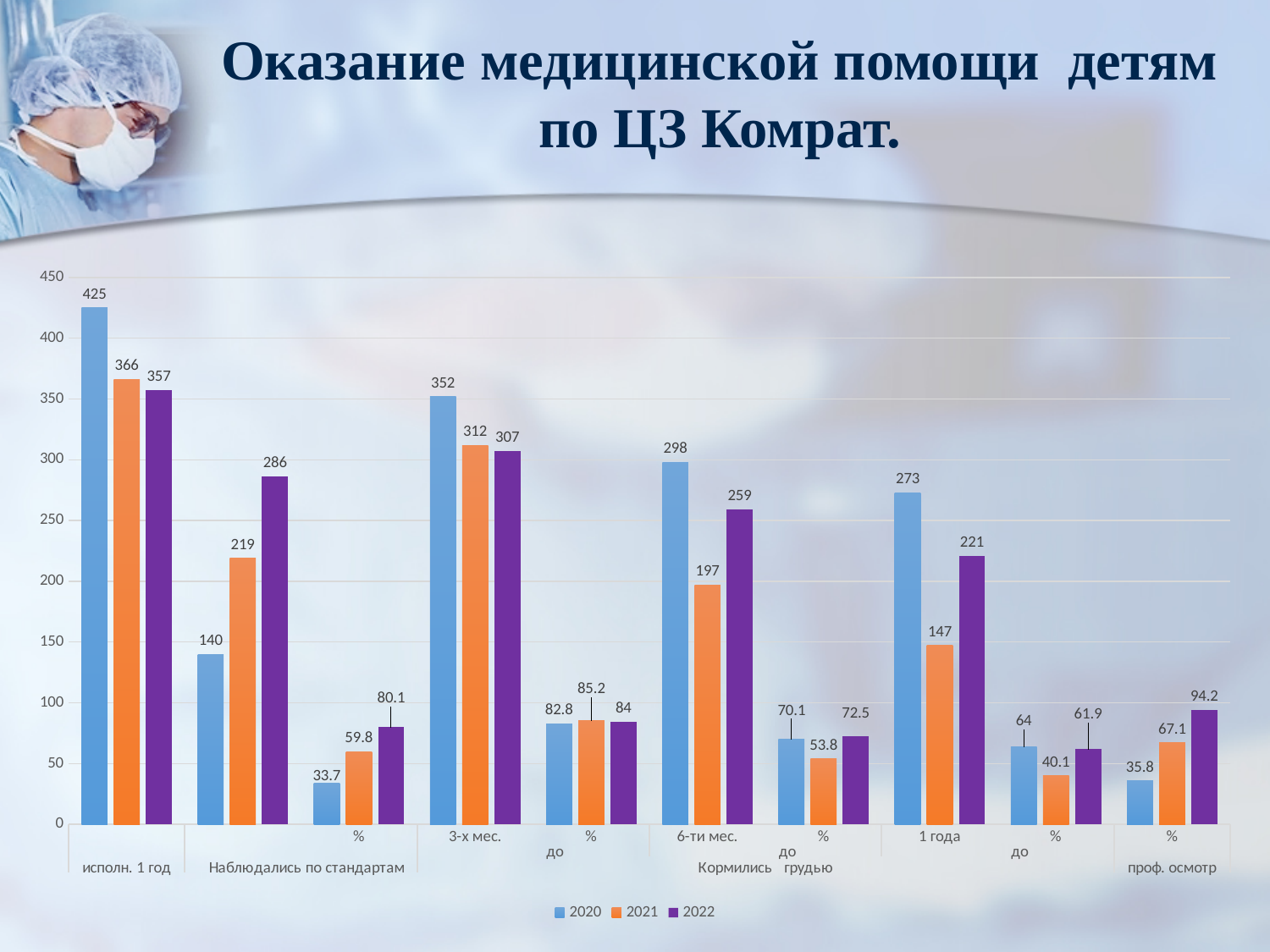
Which is larger in the "3-х мес." category: the 2021 value or the 2022 value? 2021 What is the value for 2022 in the "Наблюдались по стандартам" category? 286 What is the value for 2020 in the "исполн. 1 год" category? 425 Which year has the highest value in the "исполн. 1 год" category? 2020 What is the value for 2021 in the "6-ти мес." category? 197 Do the values for the "проф. осмотр" % category rise or fall from 2020 to 2022? Rise How many series does the legend list? 3 What is the difference between the 2020 and 2021 values in the "исполн. 1 год" category? 59 Which year has the lowest value in the "1 года" category? 2021 What is the value for 2021 in the "проф. осмотр" % category? 67.1 What kind of chart is shown on the slide? Bar chart What is the title of the slide? Оказание медицинской помощи детям по ЦЗ Комрат.